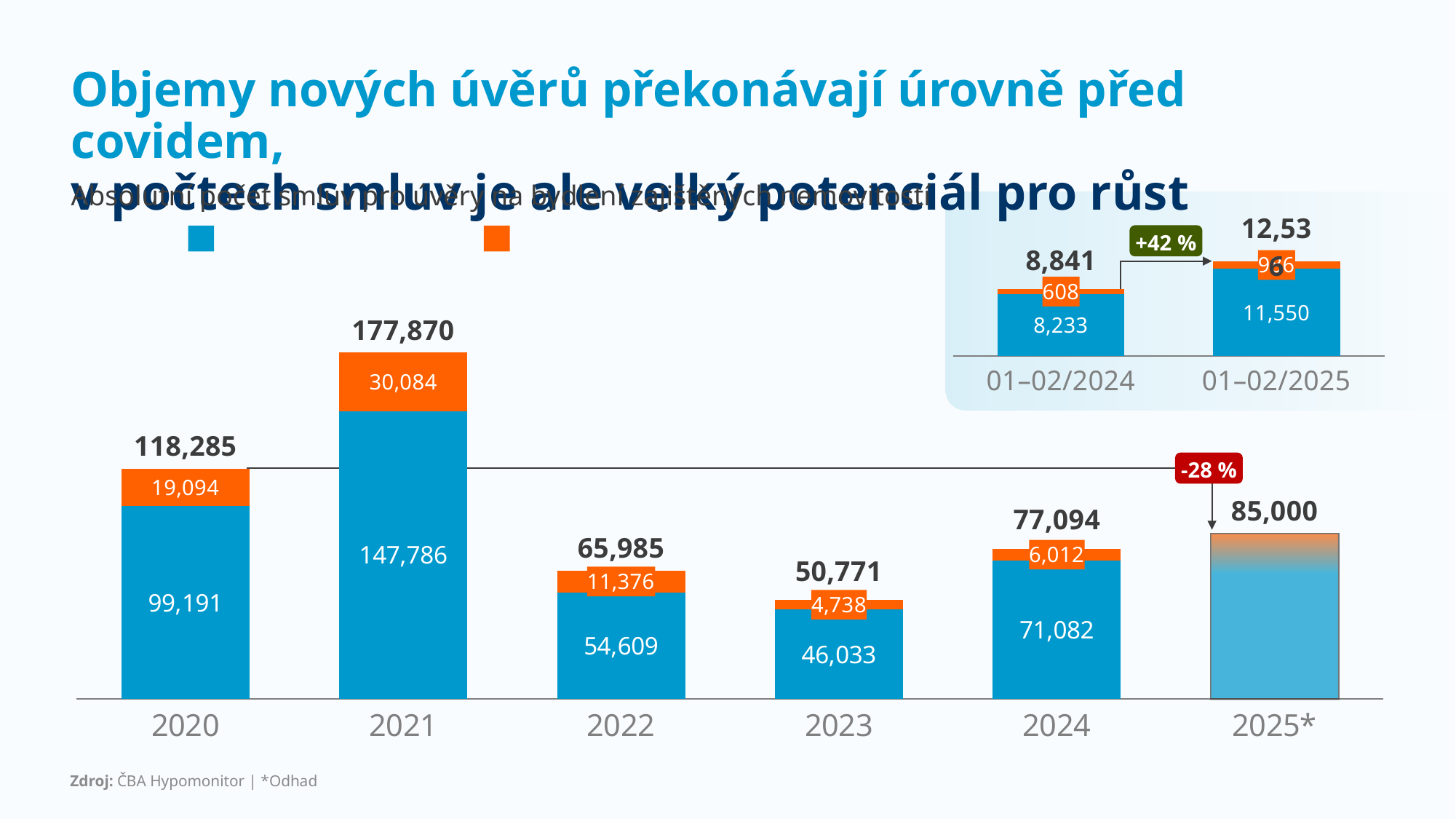
In the main chart, what is the value of the blue segment for 2020? 99,191 In the main chart, which is larger: the blue segment for 2024 or the blue segment for 2022? 2024 (71,082) In the main chart, which year has the highest total? 2021 In the main chart, which year has the lowest total? 2023 In the main chart, what is the estimated value shown for 2025*? 85,000 In the inset chart at the top right, what is the total for 01–02/2024? 8,841 In the main chart, how many years are shown on the x axis? 6 In the main chart, what is the total value shown above the bar for 2021? 177,870 In the inset chart at the top right, what percentage change is shown between 01–02/2024 and 01–02/2025? +42 % What kind of chart is the main chart? Stacked bar chart In the main chart, what is the value of the orange segment for 2022? 11,376 In the main chart, what is the difference between the totals for 2021 and 2020? 59,585